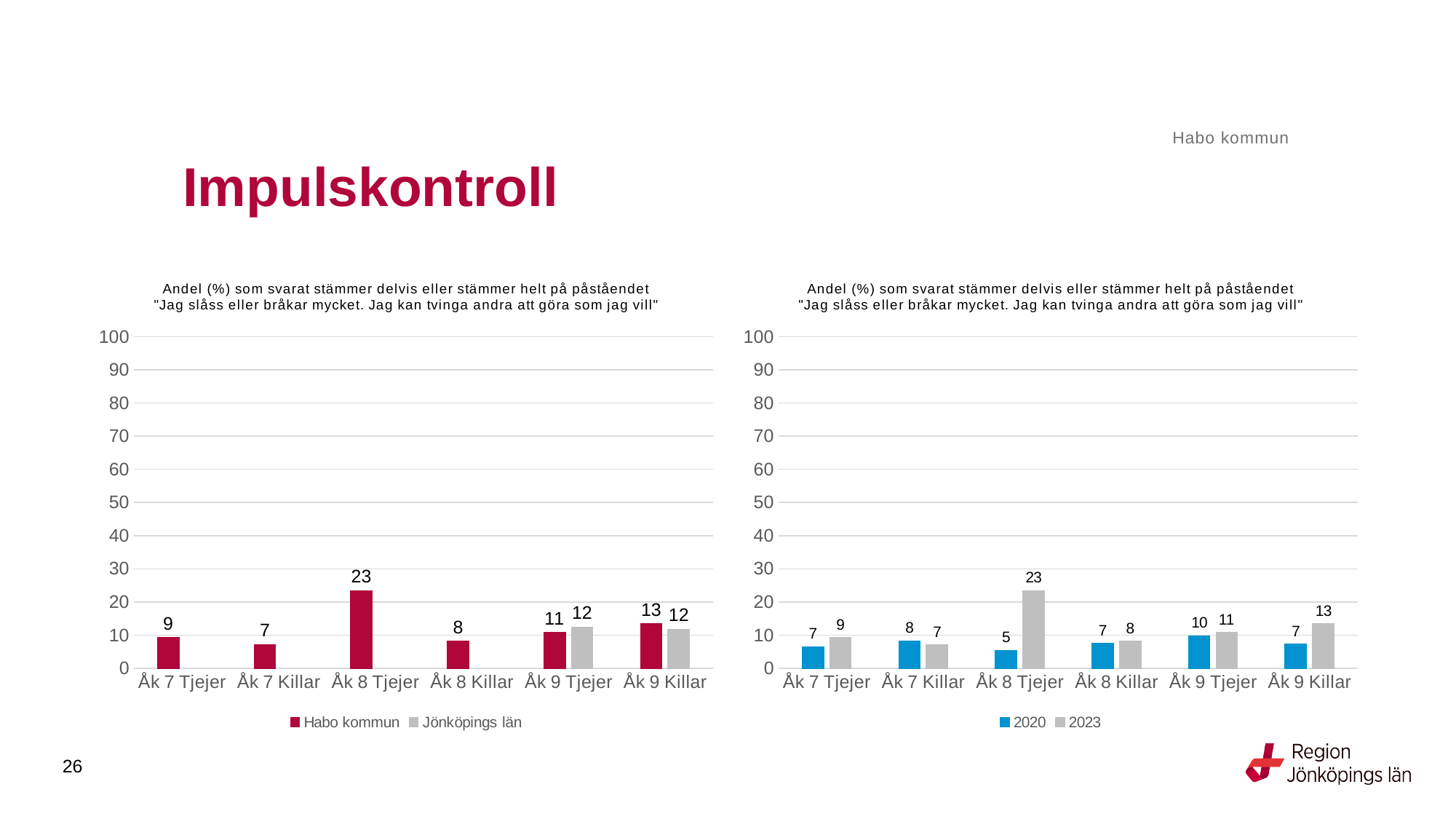
In the right chart, what is the value for 2020 for Åk 8 Tjejer? 5 In the left chart, what is the value for Habo kommun for Åk 8 Tjejer? 23 In the right chart, which is larger for Åk 7 Killar: the 2020 value or the 2023 value? 2020 In the left chart, which category has the lowest value for Habo kommun? Åk 7 Killar In the left chart, how many series does the legend list? 2 In the left chart, how many categories are shown on the x axis? 6 In the left chart, what is the value for Jönköpings län for Åk 9 Tjejer? 12 In the left chart, what is the difference between the Habo kommun values for Åk 9 Killar and Åk 7 Killar? 6 What kind of chart is the right chart? Bar chart In the right chart, what is the value for 2023 for Åk 9 Killar? 13 In the right chart, which category has the highest value for 2023? Åk 8 Tjejer In the right chart, what is the difference between the 2023 and 2020 values for Åk 8 Tjejer? 18